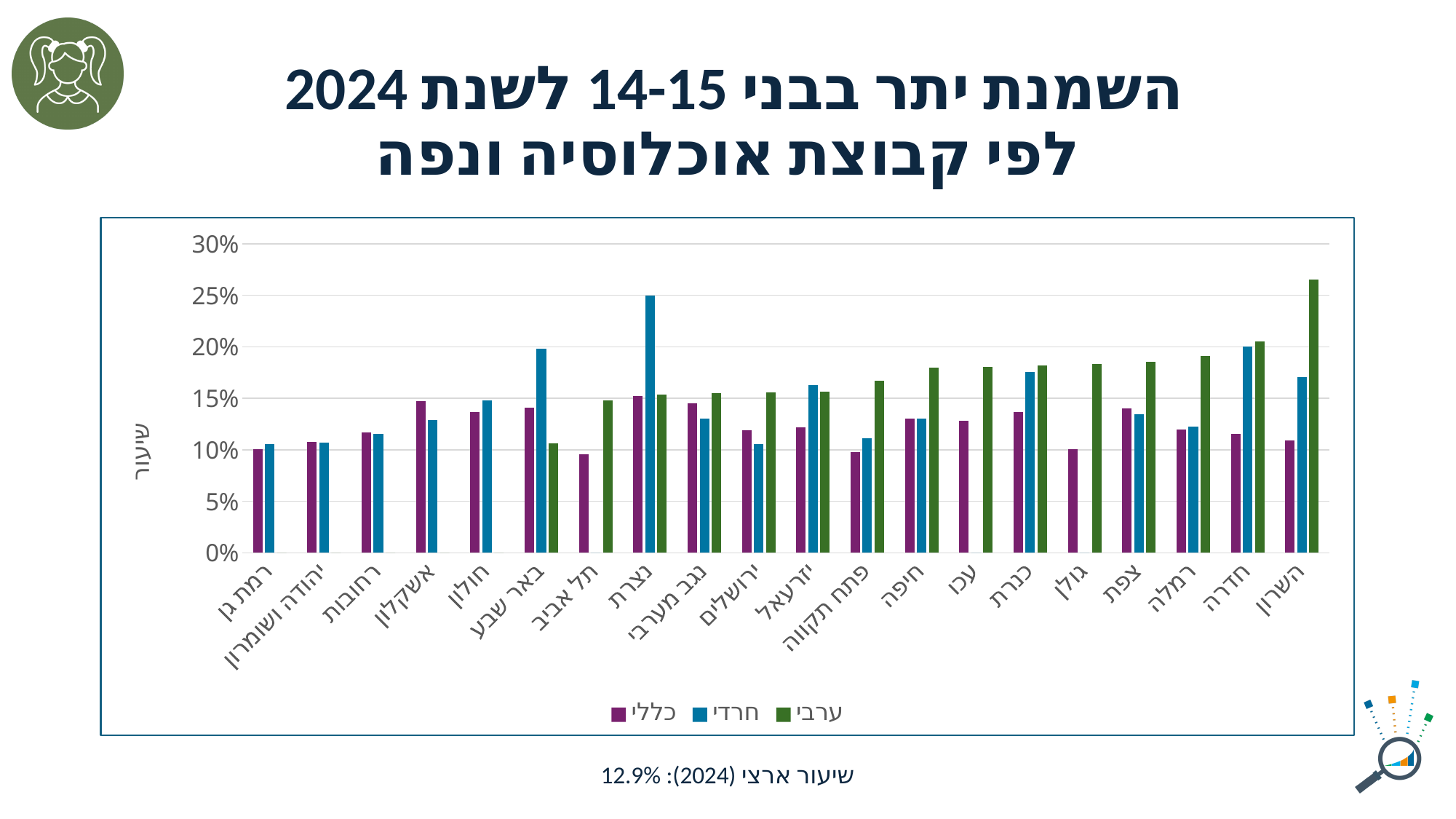
In באר שבע, which is larger: the חרדי value or the ערבי value? חרדי Which district has the highest ערבי value? השרון How many series does the legend list? 3 What kind of chart is shown on the slide? bar chart How many districts (categories) are shown on the x axis? 20 What are the three legend entries of the chart? כללי, חרדי, ערבי In נצרת, which is larger: the חרדי value or the כללי value? חרדי Which district has the highest חרדי value? נצרת Is the ערבי value for השרון greater or less than 25%? greater Is the חרדי value for באר שבע greater or less than 15%? greater